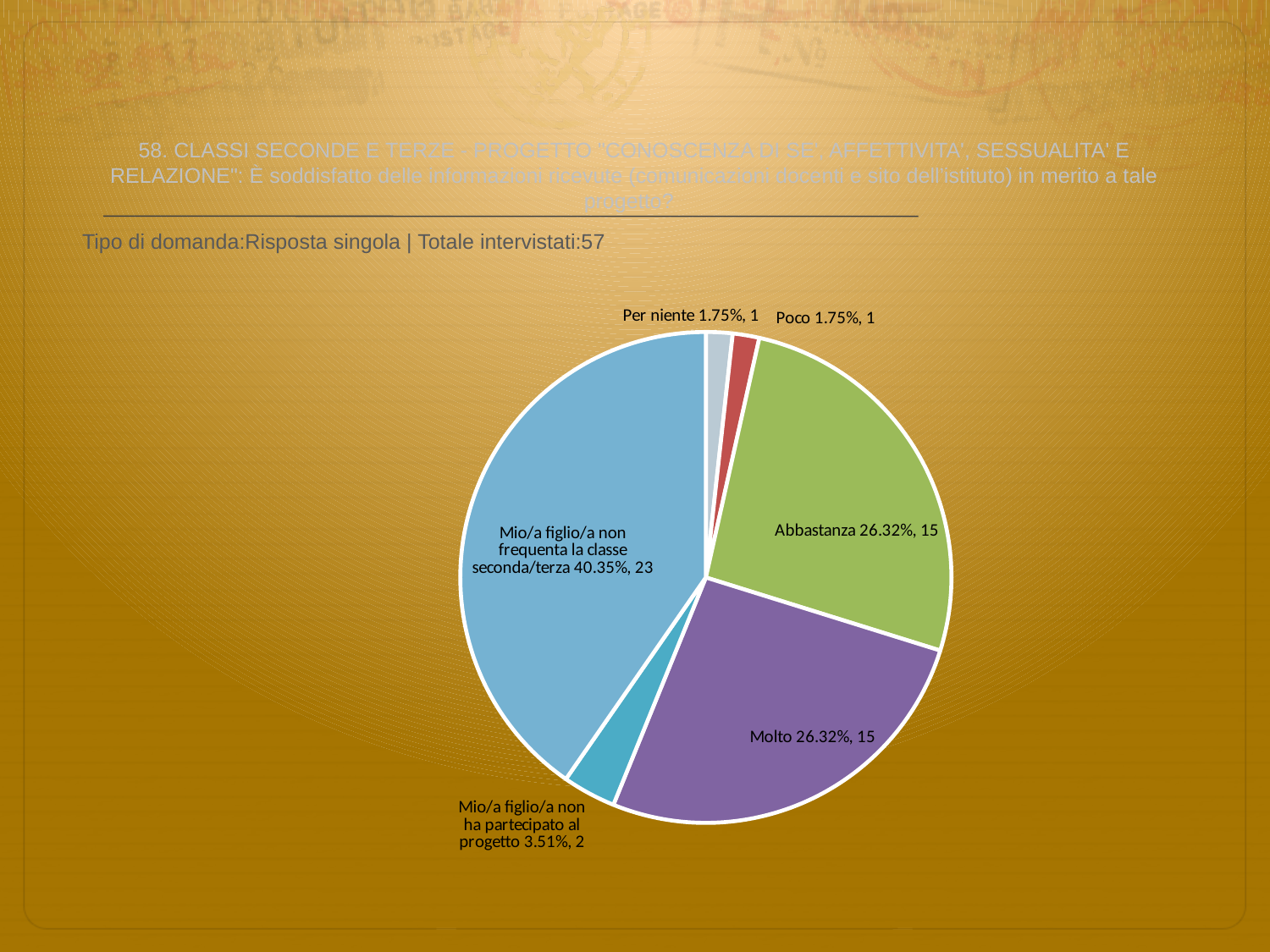
What colour is the "Molto" slice of the pie? purple What percentage share does the "Mio/a figlio/a non frequenta la classe seconda/terza" slice have? 40.35% Which is larger: the count for "Mio/a figlio/a non ha partecipato al progetto" or the count for "Poco"? Mio/a figlio/a non ha partecipato al progetto What is the difference in number of respondents between "Mio/a figlio/a non frequenta la classe seconda/terza" and "Abbastanza"? 8 Which category has the largest slice of the pie? Mio/a figlio/a non frequenta la classe seconda/terza What percentage share does the "Abbastanza" slice have? 26.32% What percentage share does the "Per niente" slice have? 1.75% What is the total number of respondents (Totale intervistati) stated on the slide? 57 How many respondents answered "Mio/a figlio/a non ha partecipato al progetto"? 2 How many slices does the pie chart have? 6 How many respondents answered "Molto"? 15 What kind of chart is shown on the slide? pie chart